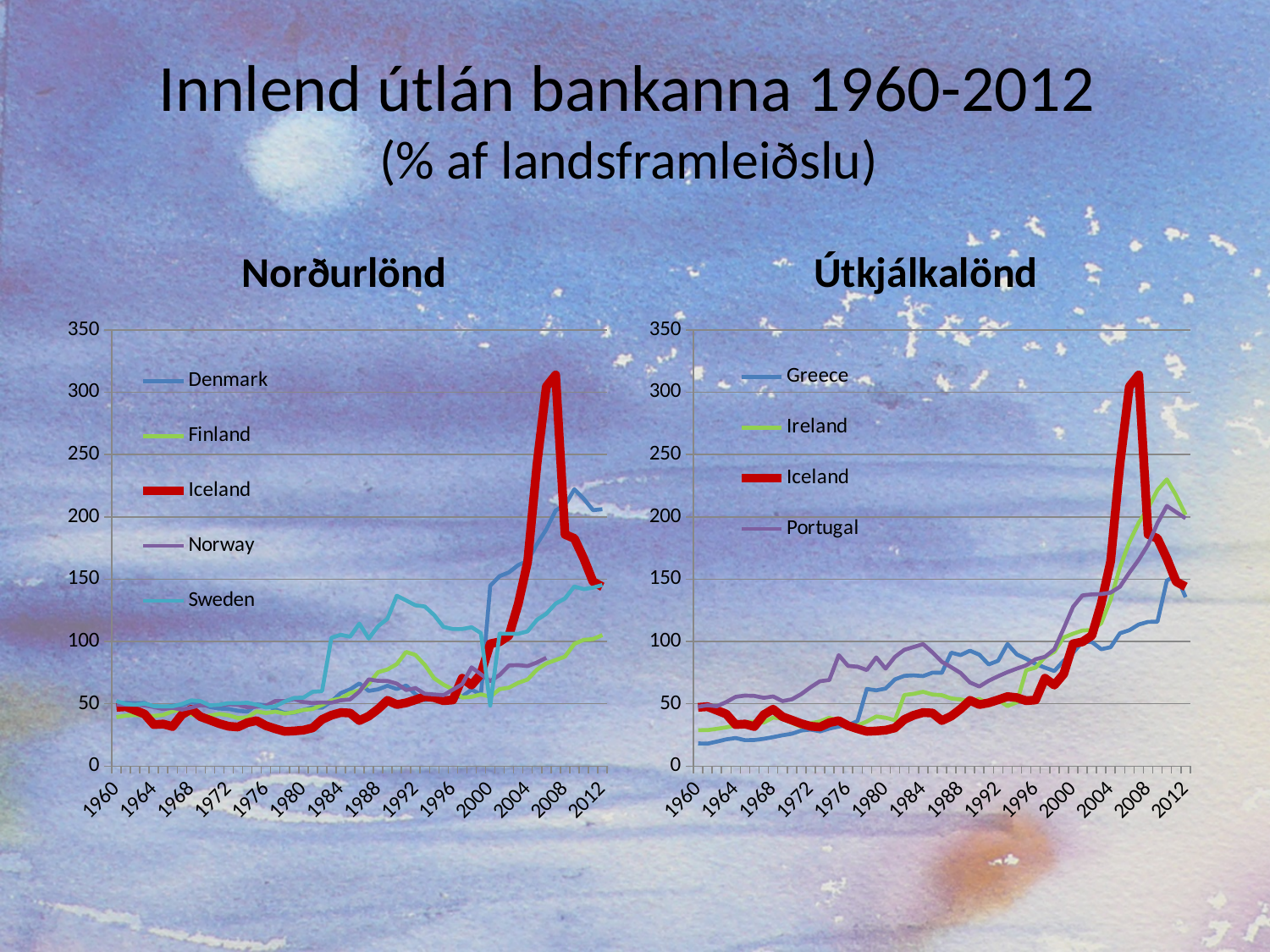
How many series does the legend of the Útkjálkalönd chart list? 4 In the Norðurlönd chart, is the peak value for Iceland around 2007 greater or less than 300? greater In the Norðurlönd chart, does the Iceland series overall rise or fall from 1960 to 2008? rise In the Útkjálkalönd chart, is the value for Greece in 1960 greater or less than 50? less In the Norðurlönd chart, is the value for Sweden in 1990 greater or less than 100? greater How many series does the legend of the Norðurlönd chart list? 5 What kind of chart is the Norðurlönd chart on the left? line chart In the Útkjálkalönd chart, which series reaches a higher peak, Ireland or Greece? Ireland In the Norðurlönd chart, which series reaches the highest value? Iceland Which country appears in the legends of both charts? Iceland In the Útkjálkalönd chart, which series reaches the highest value? Iceland